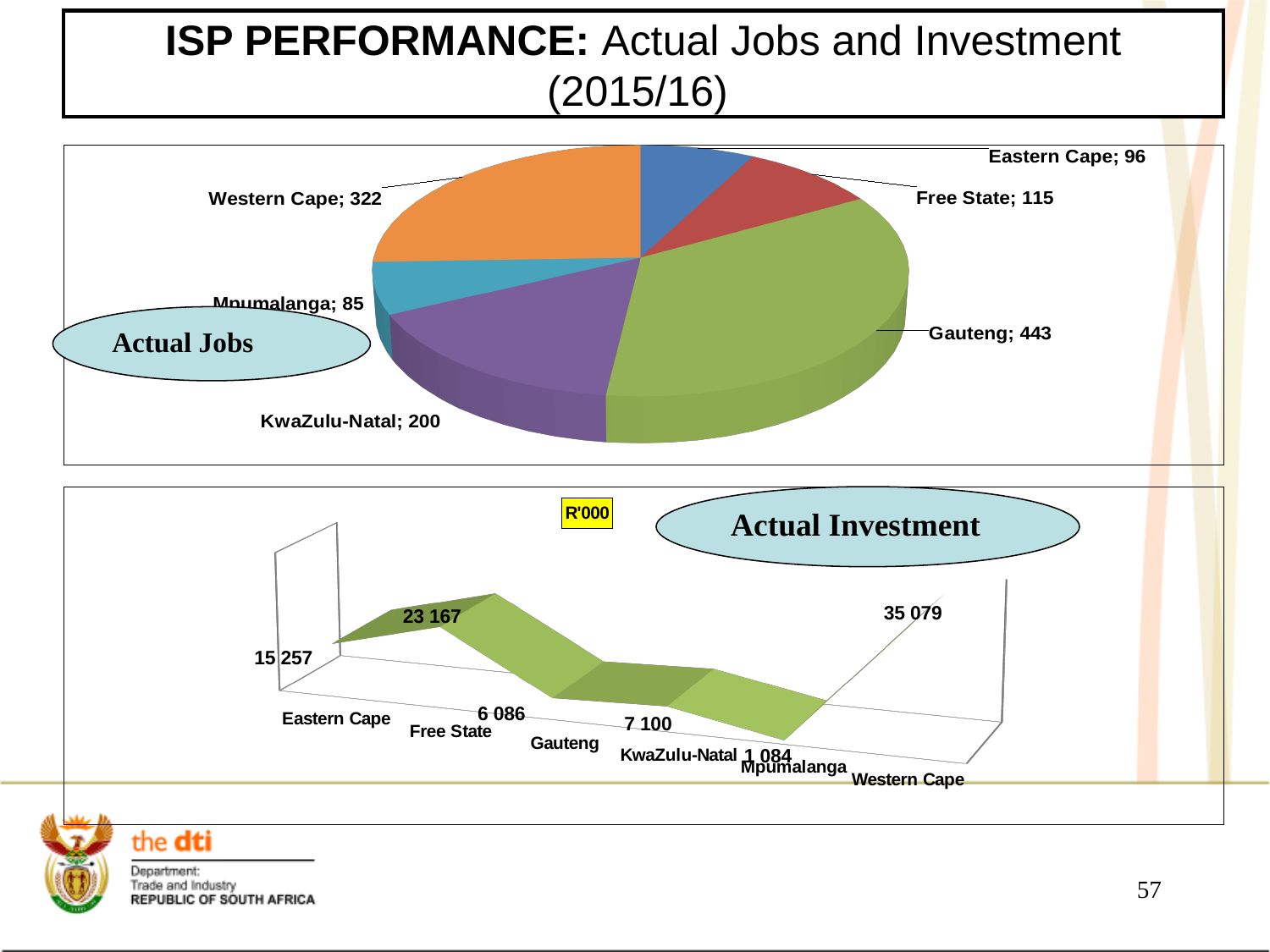
How many provinces are shown in the Actual Jobs pie chart? 6 In the Actual Jobs pie chart, which province has the highest number of actual jobs? Gauteng In the Actual Investment chart, what is the difference between the Free State and Gauteng values? 17 081 In the Actual Investment chart, which province has the lowest investment value? Mpumalanga In the Actual Investment chart, which is larger: the value for Free State or the value for Eastern Cape? Free State In the Actual Investment chart, what is the value for Western Cape? 35 079 In the Actual Jobs pie chart, which province has the lowest number of actual jobs? Mpumalanga In the Actual Jobs pie chart, what is the total number of actual jobs across all provinces? 1 261 In the Actual Jobs pie chart, how many actual jobs are shown for Gauteng? 443 In the Actual Jobs pie chart, what is the difference between the Western Cape and KwaZulu-Natal values? 122 What kind of chart is the Actual Jobs chart? Pie chart What unit label is shown in the yellow box on the Actual Investment chart? R'000